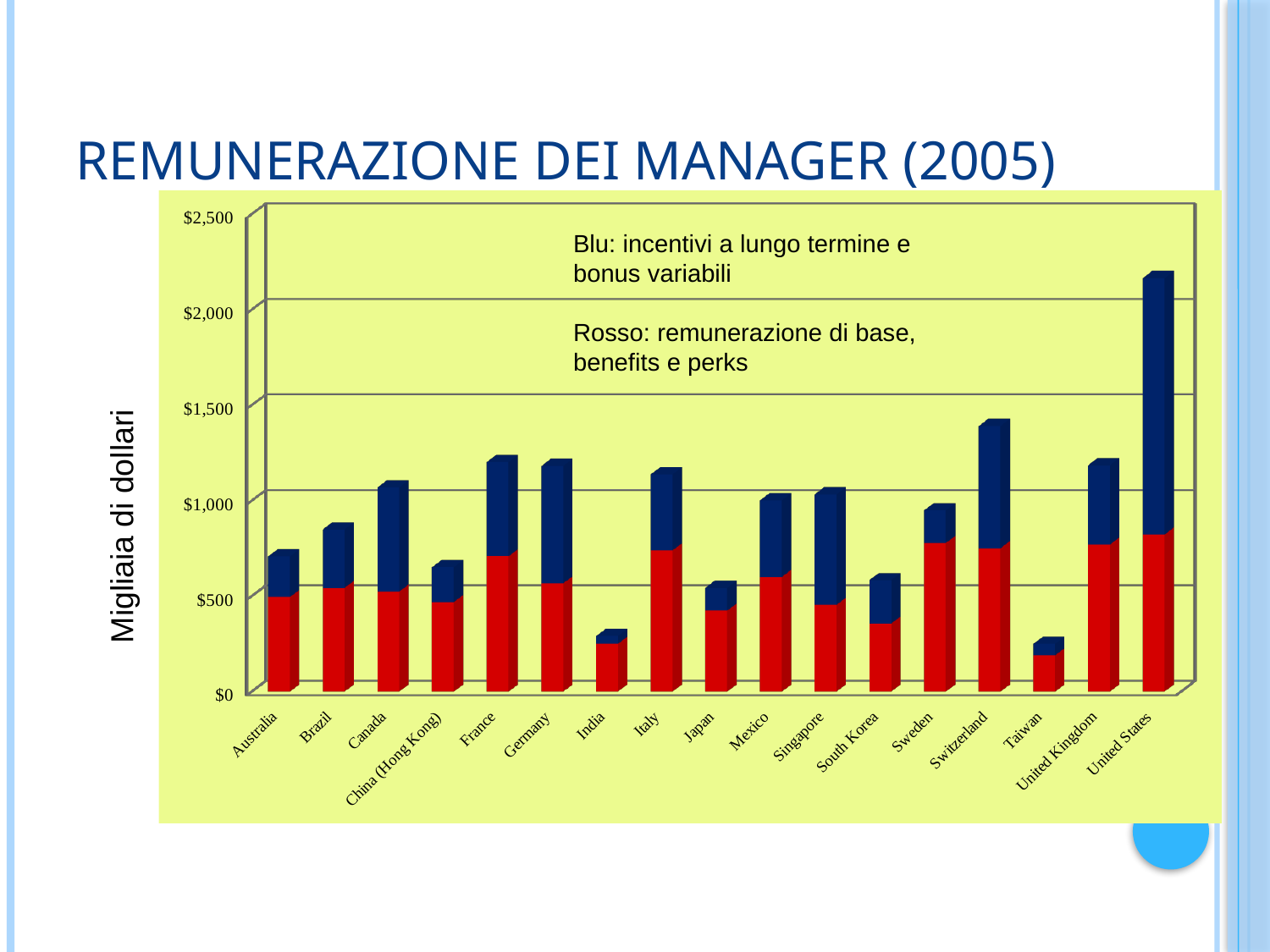
What kind of chart is shown on the slide? Stacked bar chart How many countries are shown on the x axis of the chart? 17 According to the text on the chart, what does the blue part of each bar represent? Incentivi a lungo termine e bonus variabili Is the total value for Switzerland greater or less than $1,000? greater Is the total value for United States greater or less than $2,000? greater What is the label of the vertical axis of the chart? Migliaia di dollari Which has the larger total bar, France or Japan? France Which country has the highest total bar in the chart? United States Is the total value for Japan greater or less than $1,000? less Which has the larger total bar, Switzerland or United Kingdom? Switzerland Which has the larger total bar, Canada or Brazil? Canada